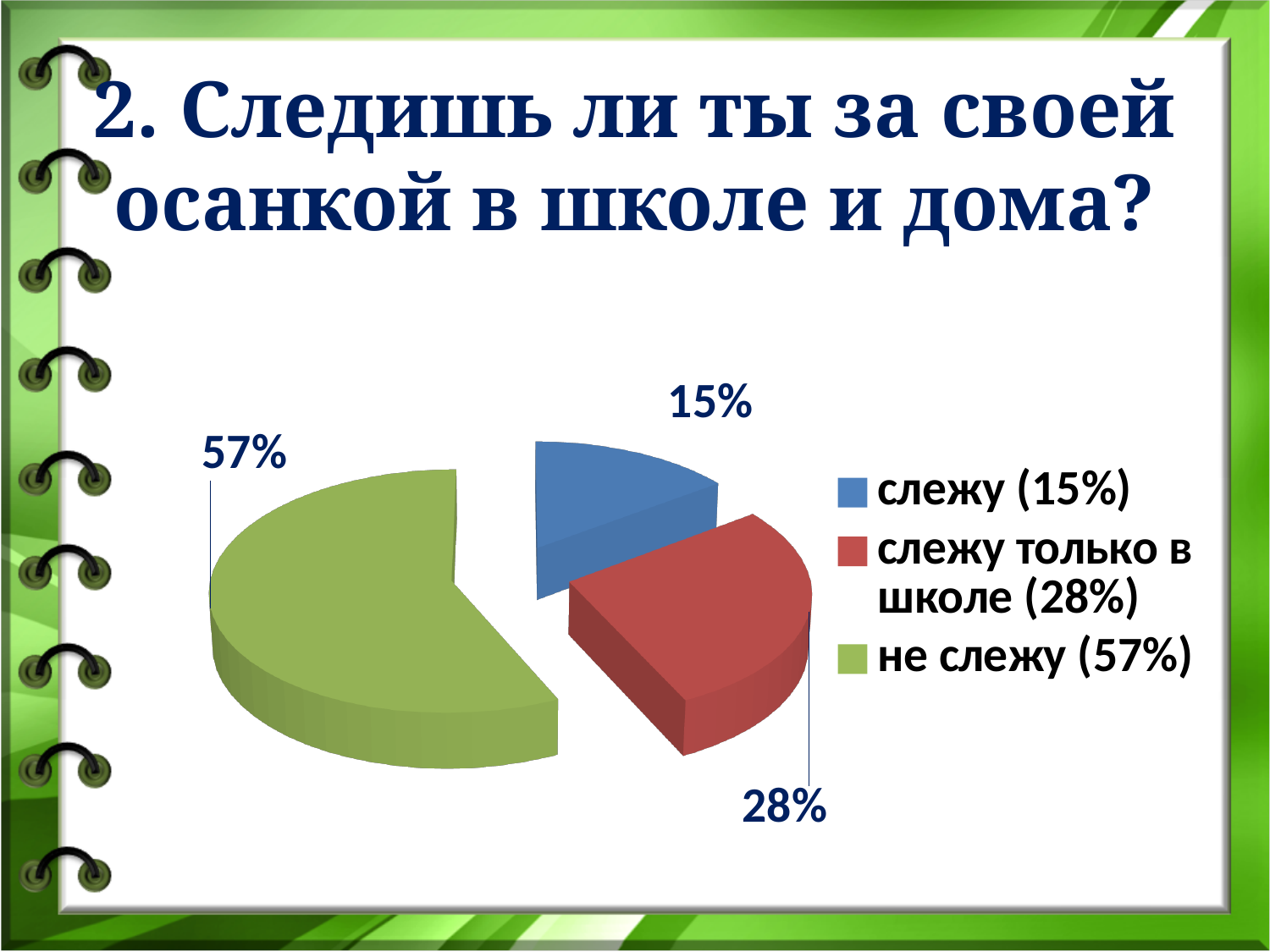
What colour is the slice for "слежу"? blue What percentage is shown for the slice labelled "не слежу"? 57% How many slices does the pie chart have? 3 Which category has the smallest slice of the pie? слежу Which is larger: the slice for "слежу" or the slice for "слежу только в школе"? слежу только в школе What kind of chart is shown on the slide? pie chart What is the difference in percentage points between "слежу только в школе" and "слежу"? 13 What percentage is shown for the slice labelled "слежу"? 15% What is the difference in percentage points between "не слежу" and "слежу только в школе"? 29 Which category has the largest slice of the pie? не слежу What percentage is shown for the slice labelled "слежу только в школе"? 28% What colour is the slice for "не слежу"? green